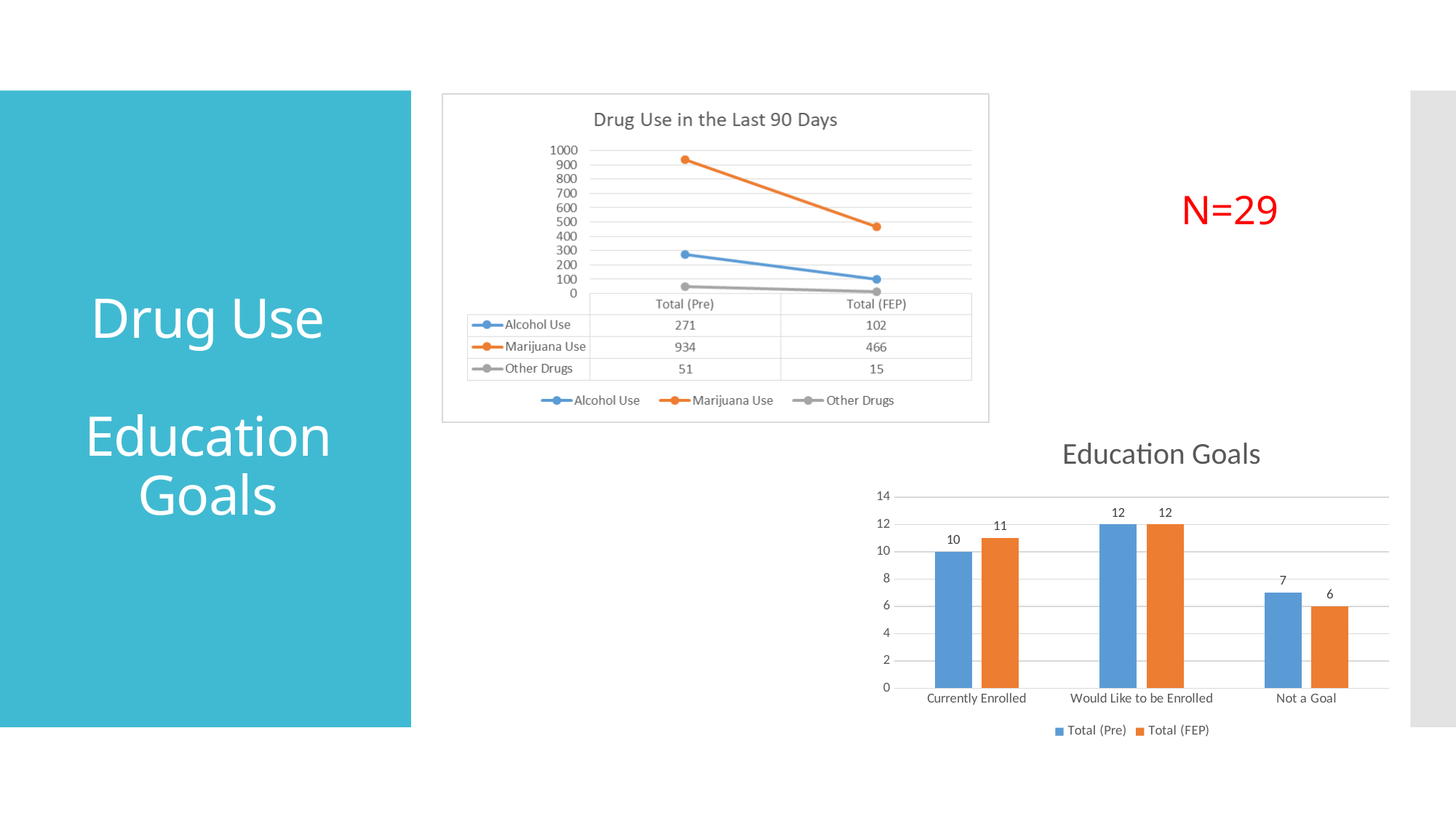
In the 'Drug Use in the Last 90 Days' chart, does the Alcohol Use series rise or fall from Total (Pre) to Total (FEP)? fall In the 'Education Goals' chart, which is larger for Not a Goal: Total (Pre) or Total (FEP)? Total (Pre) In the 'Education Goals' chart, how many categories are shown on the x axis? 3 In the 'Education Goals' chart, what is the Total (FEP) value for Currently Enrolled? 11 In the 'Drug Use in the Last 90 Days' chart, what is the Alcohol Use value for Total (FEP)? 102 In the 'Drug Use in the Last 90 Days' chart, how many series does the legend list? 3 In the 'Drug Use in the Last 90 Days' chart, what is the Marijuana Use value for Total (Pre)? 934 What kind of chart is 'Drug Use in the Last 90 Days'? line chart In the 'Education Goals' chart, which category has the highest Total (Pre) value? Would Like to be Enrolled What kind of chart is 'Education Goals'? bar chart In the 'Drug Use in the Last 90 Days' chart, which series has the lowest value at Total (FEP)? Other Drugs In the 'Drug Use in the Last 90 Days' chart, what is the difference between the Marijuana Use values for Total (Pre) and Total (FEP)? 468